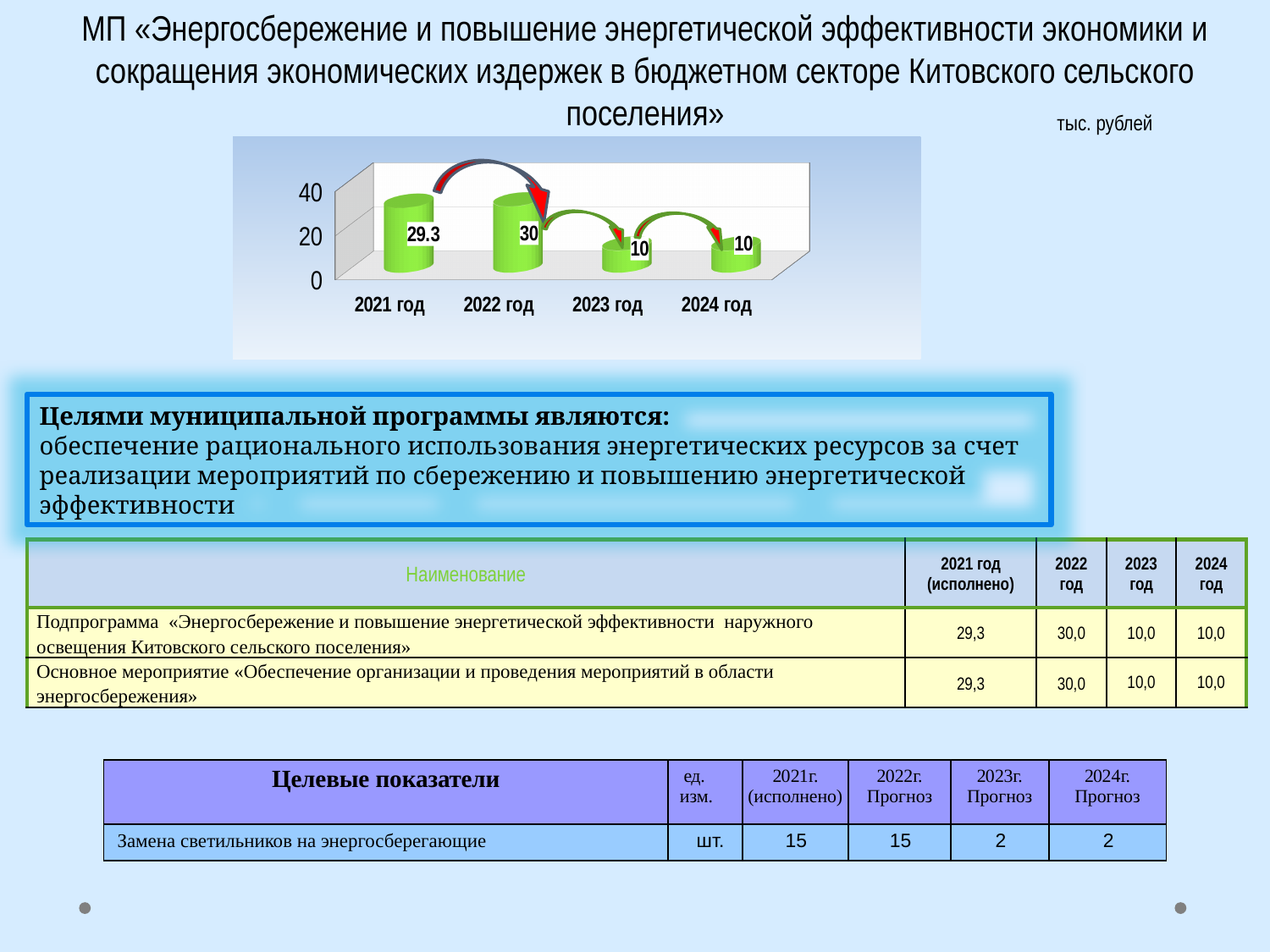
What is the value shown for 2024 год in the chart? 10 What is the value shown for 2023 год in the chart? 10 Do the values in the chart generally rise or fall from 2022 год to 2024 год? fall What kind of chart is shown on the slide? bar chart What is the value shown for 2022 год in the chart? 30 Which is larger in the chart, the value for 2021 год or the value for 2023 год? 2021 год What is the value shown for 2021 год in the chart? 29.3 What is the difference between the values for 2022 год and 2021 год in the chart? 0.7 Is the value for 2021 год in the chart greater or less than 20? greater What is the difference between the values for 2022 год and 2023 год in the chart? 20 Which year has the highest value in the chart? 2022 год How many years (categories) are plotted in the chart? 4